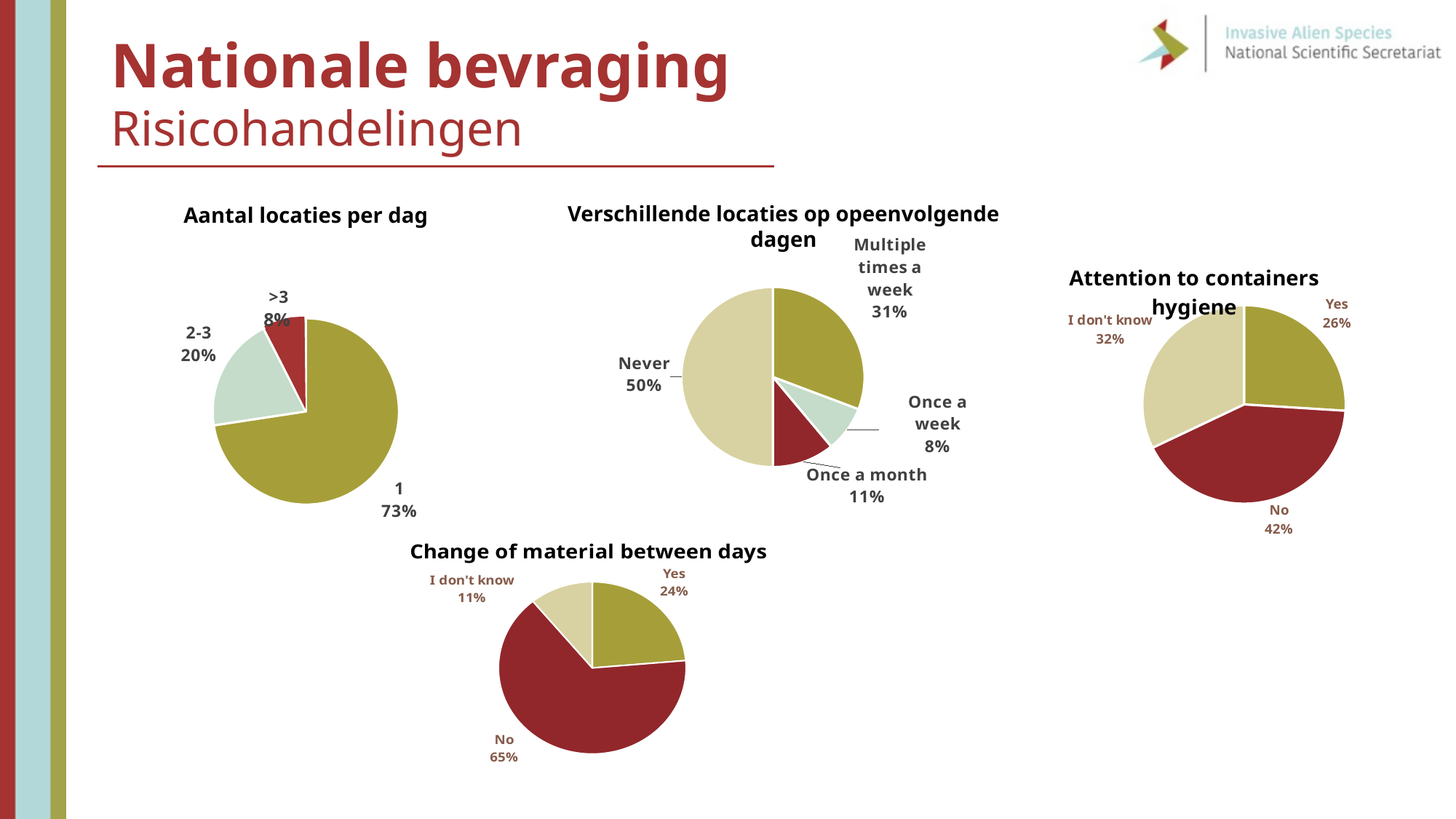
In the 'Attention to containers hygiene' chart, which category has the largest share? No In the 'Verschillende locaties op opeenvolgende dagen' chart, how many categories are shown? 4 In the 'Verschillende locaties op opeenvolgende dagen' chart, what is the value for 'Multiple times a week'? 31% What type of chart is 'Change of material between days'? Pie chart In the 'Attention to containers hygiene' chart, what is the value for 'I don't know'? 32% In the 'Verschillende locaties op opeenvolgende dagen' chart, what is the difference between 'Never' and 'Once a month'? 39% In the 'Change of material between days' chart, which is larger, 'Yes' or 'I don't know'? Yes In the 'Aantal locaties per dag' chart, how many slices does the pie have? 3 In the 'Change of material between days' chart, what is the difference between 'No' and 'Yes'? 41% In the 'Aantal locaties per dag' chart, which category has the smallest share? >3 In the 'Aantal locaties per dag' chart, what share of the pie is the '1' slice? 73% In the 'Verschillende locaties op opeenvolgende dagen' chart, what is the value for 'Never'? 50%